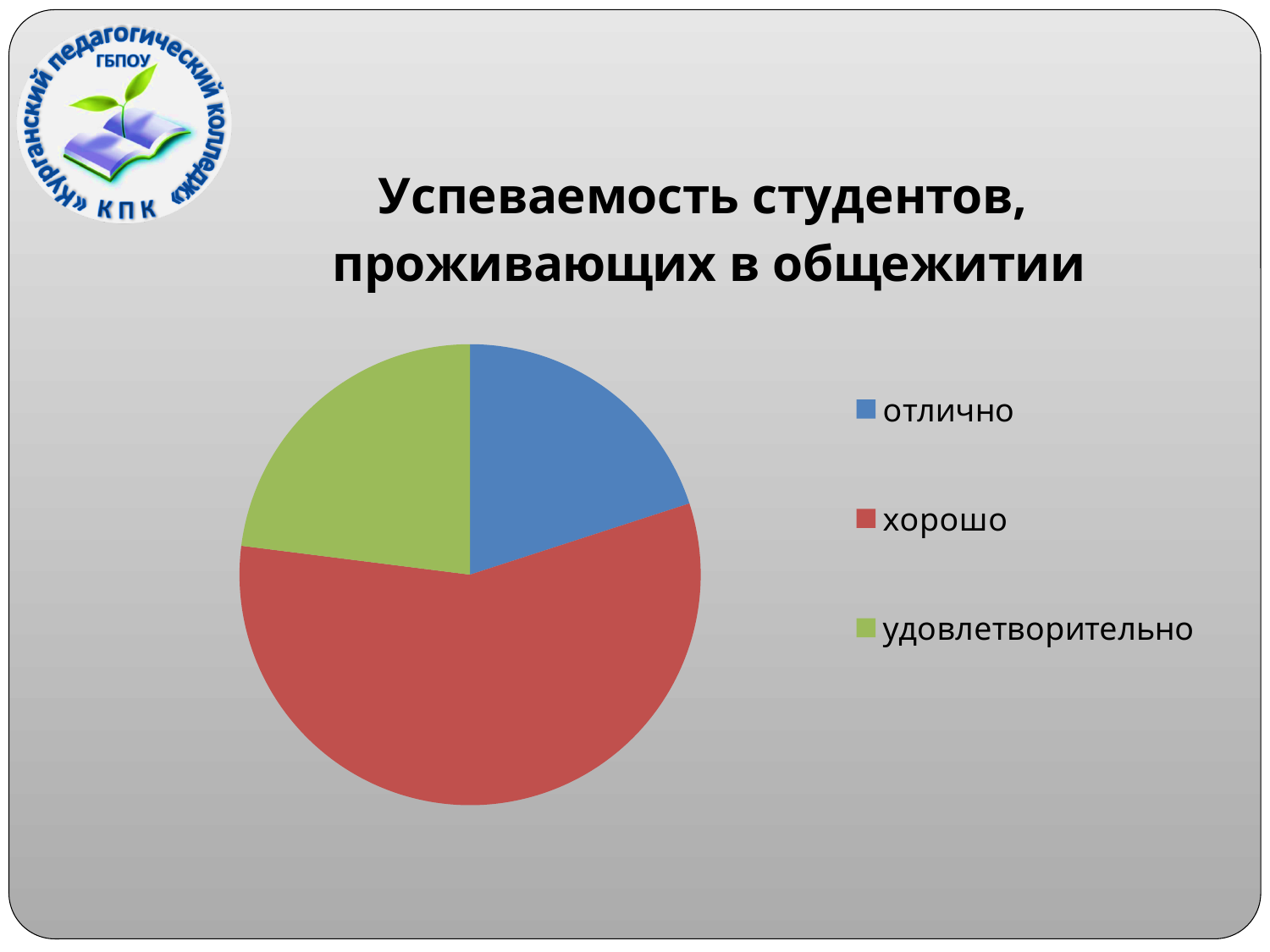
What kind of chart is shown on the slide? pie chart Which slice is larger, хорошо or отлично? хорошо Which slice is larger, удовлетворительно or отлично? удовлетворительно How many entries does the legend of the pie chart list? 3 What is the title of the chart? Успеваемость студентов, проживающих в общежитии What colour is the slice for хорошо? red Which slice is larger, хорошо or удовлетворительно? хорошо Which category has the largest slice of the pie chart? хорошо How many slices does the pie chart have? 3 Which category has the smallest slice of the pie chart? отлично